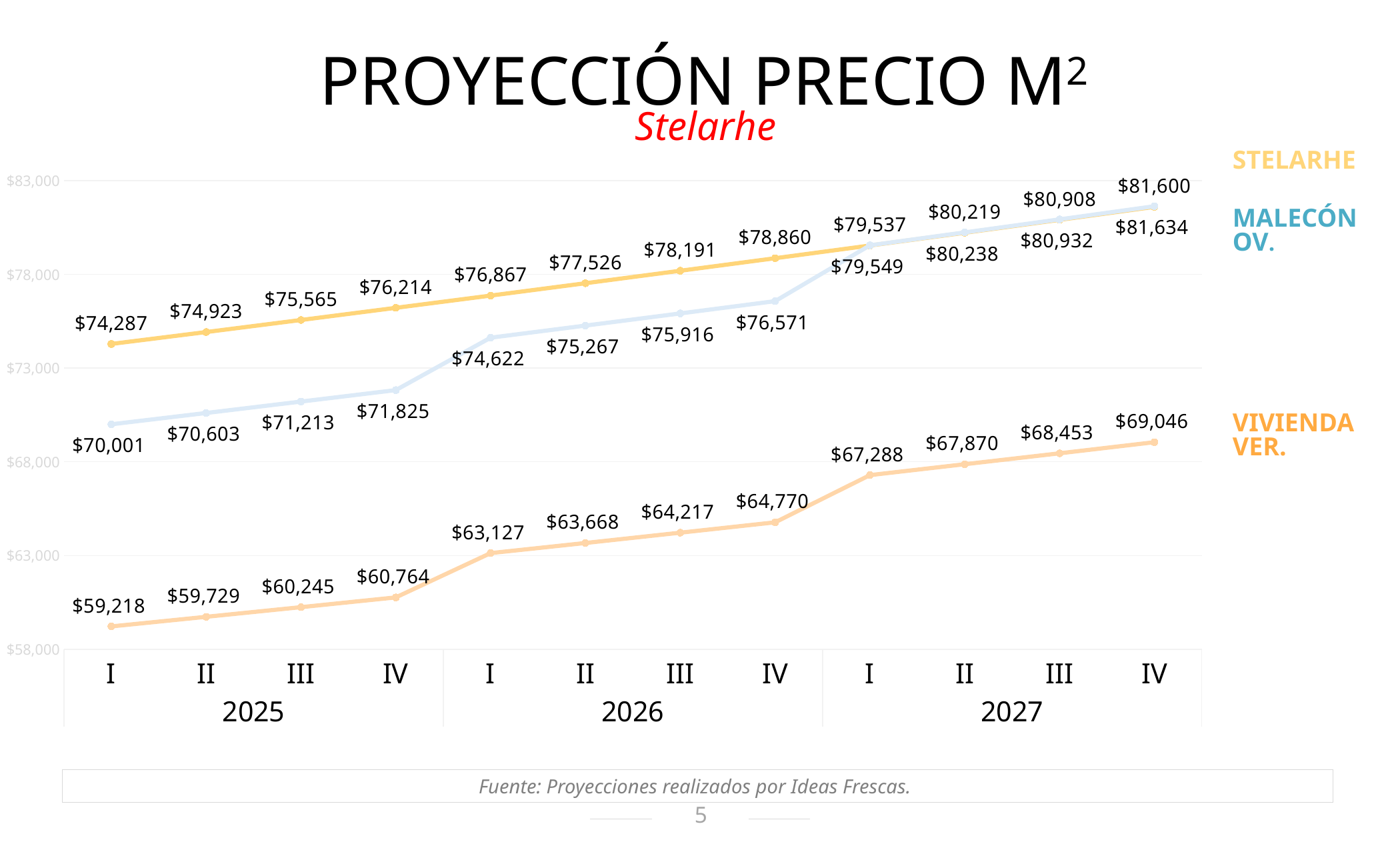
What is the projected price per m² for MALECÓN OV. in quarter I of 2026? $74,622 By how much does the STELARHE price in quarter IV of 2027 exceed its price in quarter I of 2025? $7,313 In which quarter does VIVIENDA VER. reach its highest projected price? IV 2027 What type of chart is shown on the slide? line chart What is the projected price per m² for VIVIENDA VER. in quarter IV of 2027? $69,046 What is the projected price per m² for STELARHE in quarter I of 2025? $74,287 In quarter IV of 2025, which series has the higher projected price, STELARHE or MALECÓN OV.? STELARHE In which quarter is the STELARHE projected price lowest? I 2025 What is the difference between the MALECÓN OV. price in quarter I of 2026 and quarter IV of 2025? $2,797 How many series does the chart show? 3 How many quarters are plotted along the x axis? 12 Is the MALECÓN OV. value in quarter I of 2025 greater or less than $73,000? less